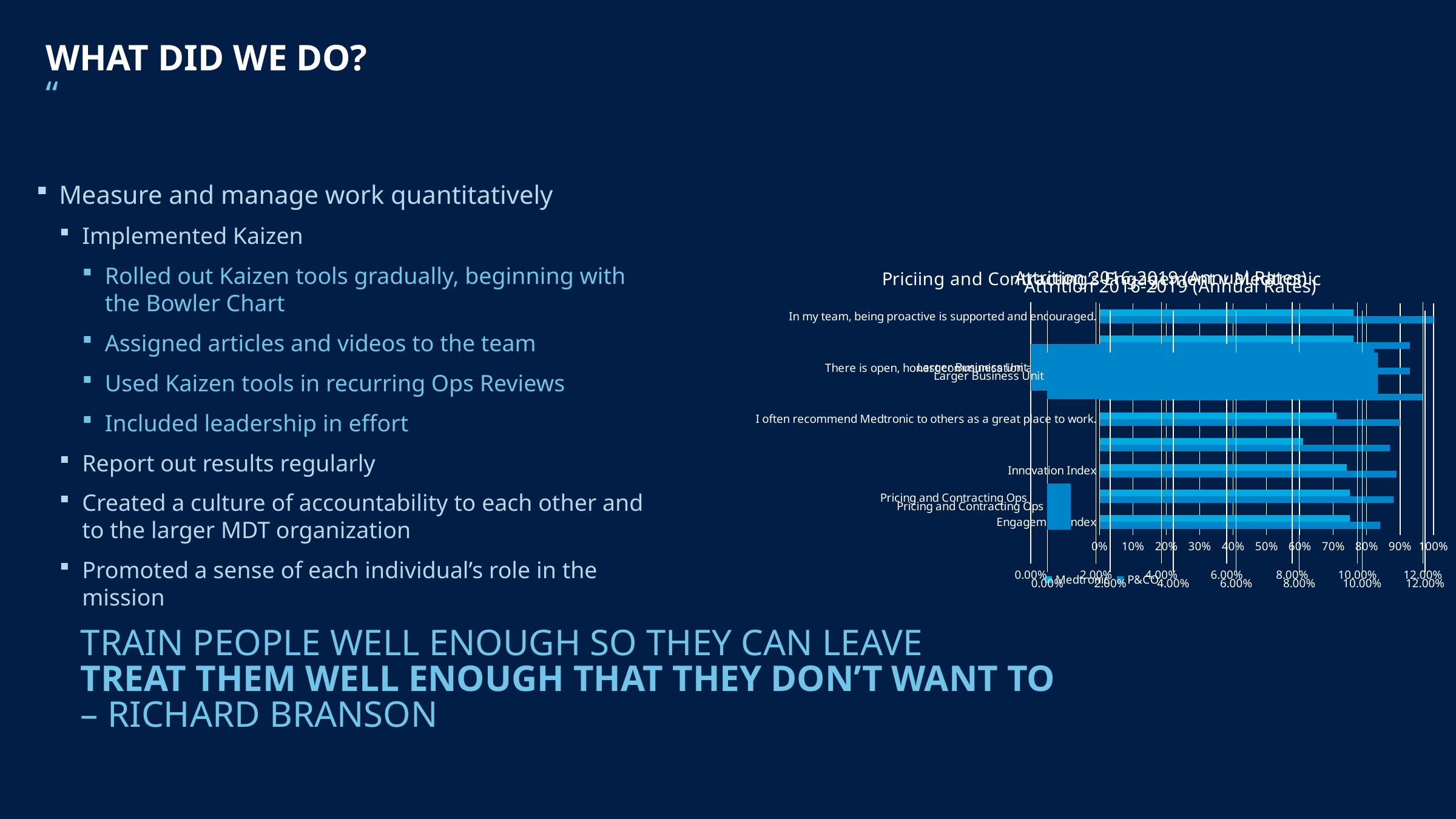
How many categories does the 'Attrition 2016-2019 (Annual Rates)' chart show? 2 How many categories does the engagement chart (with the 0% to 100% axis) show? 9 What is the highest tick value on the horizontal axis of the 'Attrition 2016-2019 (Annual Rates)' chart? 12.00% In the 'Attrition 2016-2019 (Annual Rates)' chart, which category has the highest attrition rate? Larger Business Unit In the 'Attrition 2016-2019 (Annual Rates)' chart, is the value for Pricing and Contracting Ops greater or less than 4.00%? less In the 'Attrition 2016-2019 (Annual Rates)' chart, which is larger: the value for Larger Business Unit or for Pricing and Contracting Ops? Larger Business Unit What kind of chart is the 'Attrition 2016-2019 (Annual Rates)' chart? Bar chart How many series does the legend of the engagement chart (with the 0% to 100% axis) list? 2 In the 'Attrition 2016-2019 (Annual Rates)' chart, which category has the lowest attrition rate? Pricing and Contracting Ops In the 'Attrition 2016-2019 (Annual Rates)' chart, is the value for Larger Business Unit greater or less than 8.00%? greater In the engagement chart (with the 0% to 100% axis), is the value for 'In my team, being proactive is supported and encouraged.' greater or less than 50%? greater What are the two series named in the legend of the engagement chart (with the 0% to 100% axis)? Medtronic and P&Co